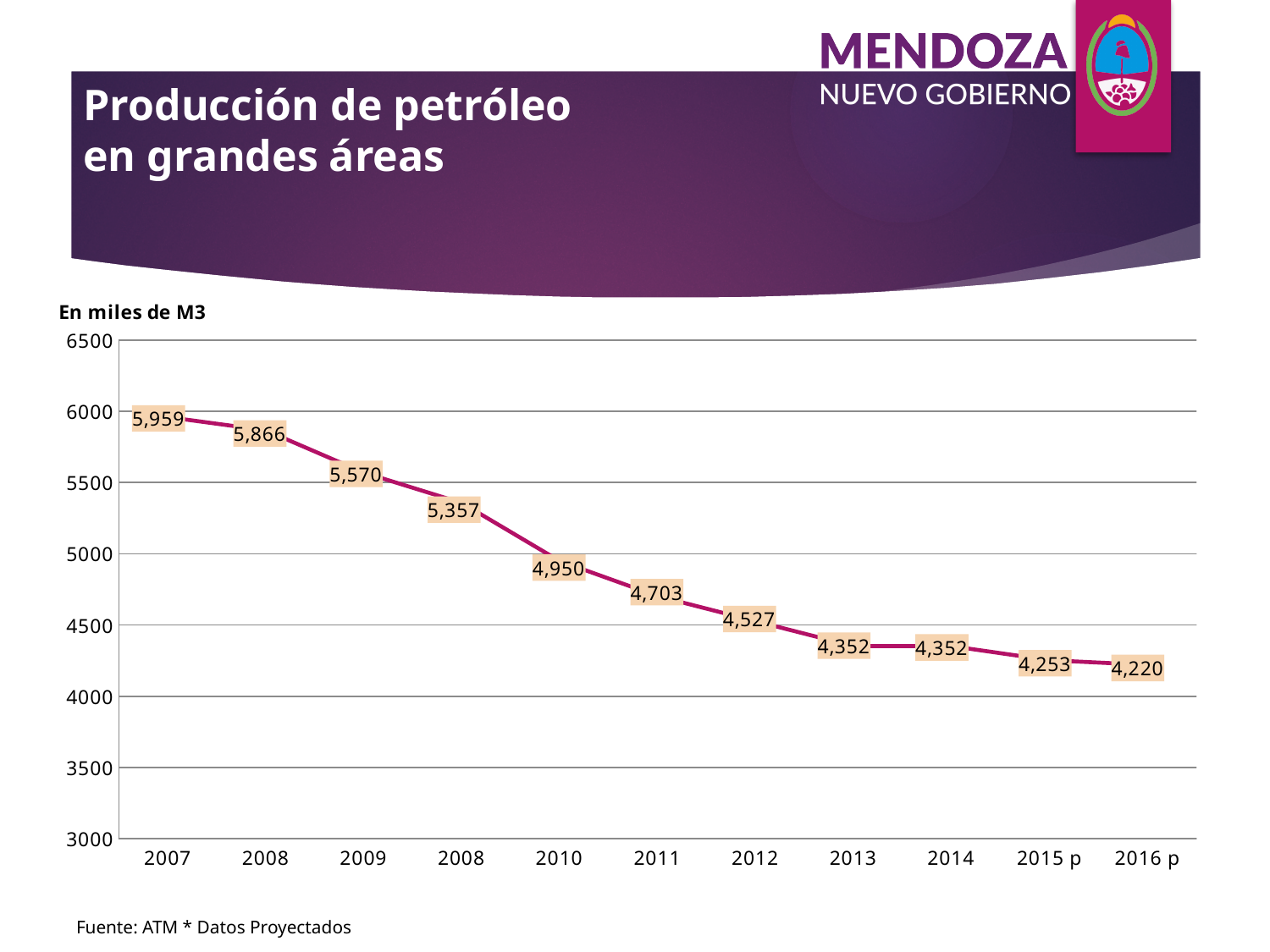
What type of chart is shown on the slide? Line chart In what unit are the values expressed, according to the label above the chart? En miles de M3 What is the value plotted for 2013? 4,352 What is the value plotted for 2010? 4,950 How many data points are plotted on the chart? 11 Do the values rise or fall from left to right along the x axis? Fall What is the oil production value for 2007? 5,959 Which year has the lowest value on the chart? 2016 p Which is larger, the value for 2011 or the value for 2012? 2011 What is the difference between the 2007 value and the 2016 p value? 1,739 Which year has the highest value on the chart? 2007 What is the projected value for 2016 p? 4,220